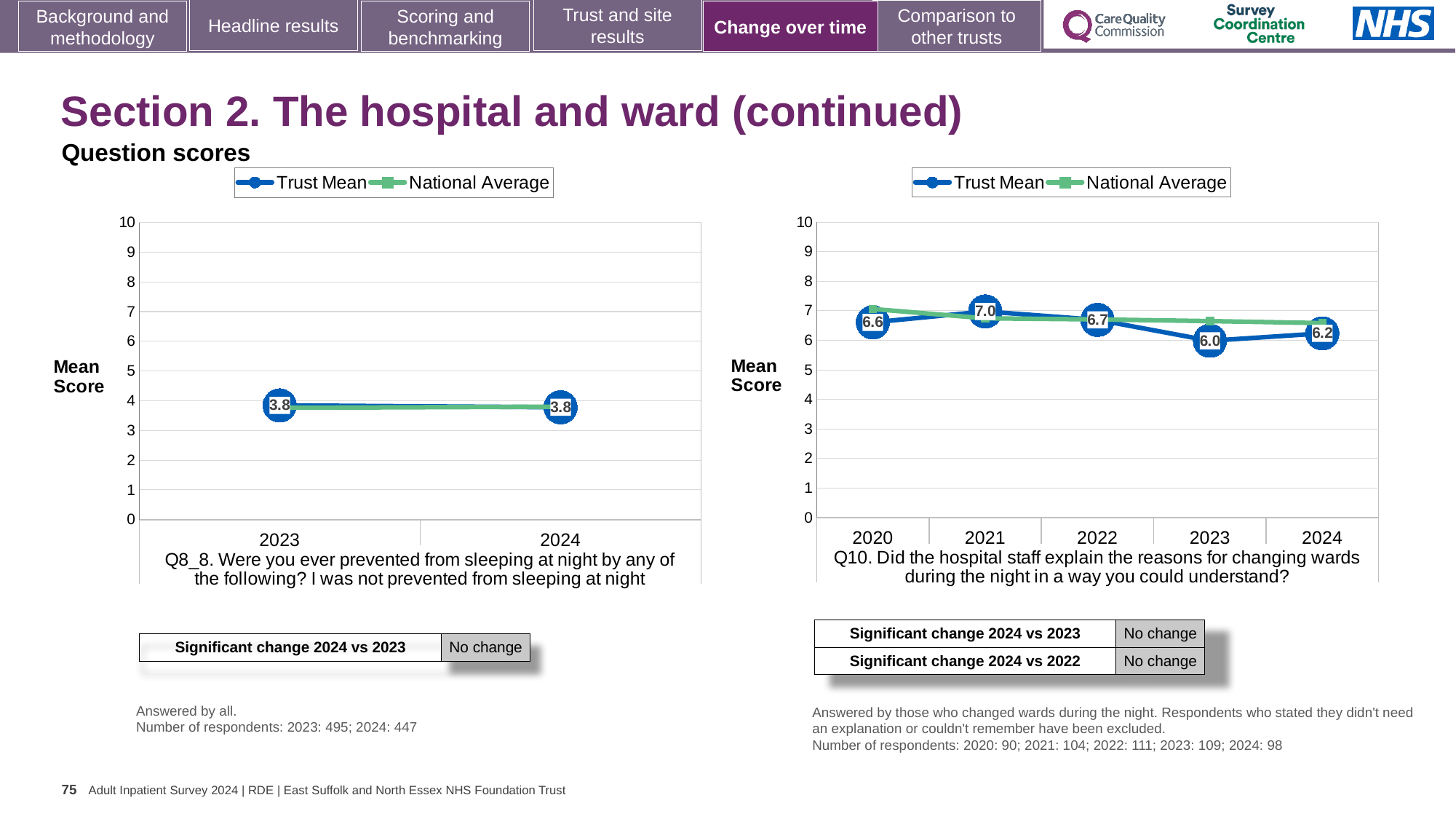
In the Q8_8 chart on the left, how many years are plotted on the x axis? 2 In the Q10 chart on the right, what is the difference between the Trust Mean for 2021 and the Trust Mean for 2023? 1.0 In the Q8_8 chart on the left, what is the Trust Mean for 2023? 3.8 In the Q10 chart on the right, which year has the highest Trust Mean? 2021 In the Q10 chart on the right, which year has the lowest Trust Mean? 2023 In the Q8_8 chart on the left, is the Trust Mean for 2024 greater or less than 5? less In the Q10 chart on the right, what is the Trust Mean for 2023? 6.0 In the Q10 chart on the right, which is larger: the Trust Mean for 2020 or the Trust Mean for 2024? 2020 In the Q10 chart on the right, how many series does the legend list? 2 In the Q10 chart on the right, what is the Trust Mean for 2021? 7.0 In the Q8_8 chart on the left, what is the Trust Mean for 2024? 3.8 What type of chart is the Q10 chart on the right? Line chart